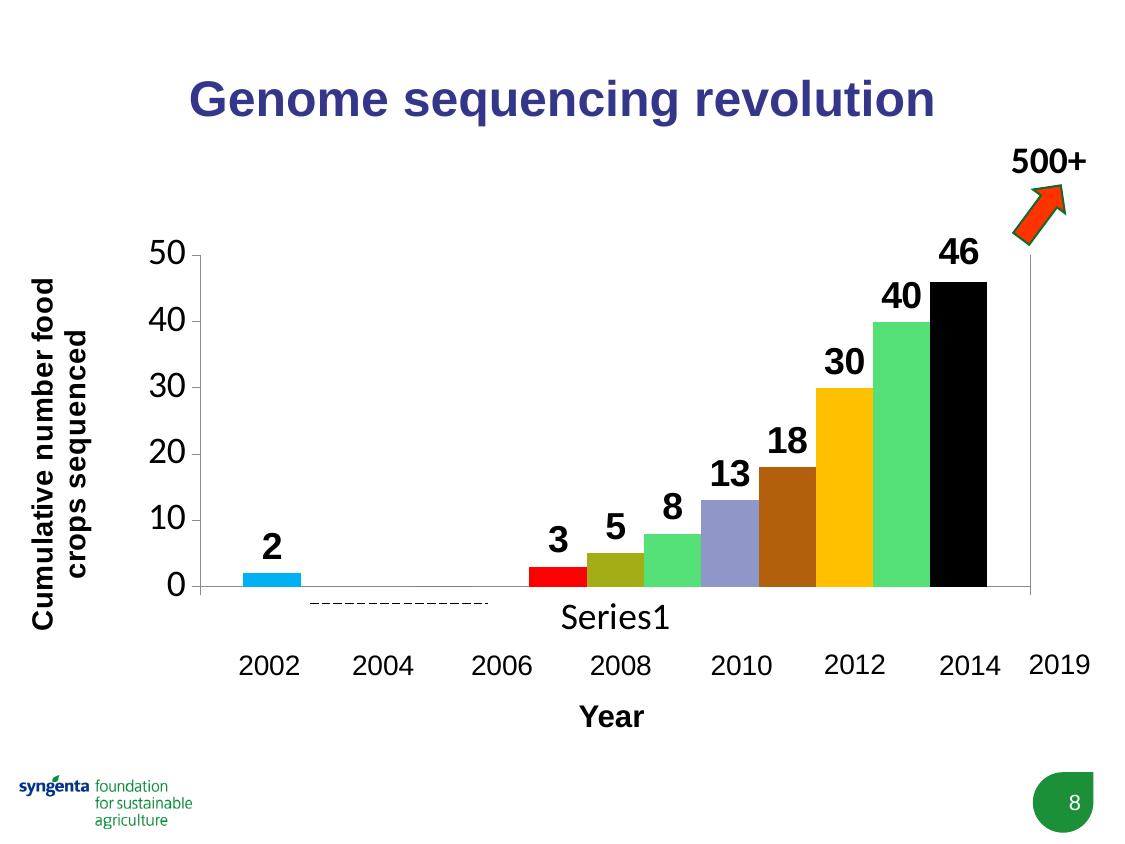
Do the bar values rise or fall from 2002 to 2014? rise How many bars are plotted in the chart? 9 What is the value shown for 2010? 13 What is the cumulative number of food crops sequenced in 2014? 46 Which labelled year has the highest bar? 2014 What kind of chart is shown on the slide? bar chart What is the difference between the values for 2014 and 2012? 16 What value is annotated with the arrow for 2019? 500+ What is the value shown for 2002? 2 What is the value shown for 2012? 30 Which is larger, the value for 2010 or the value for 2012? 2012